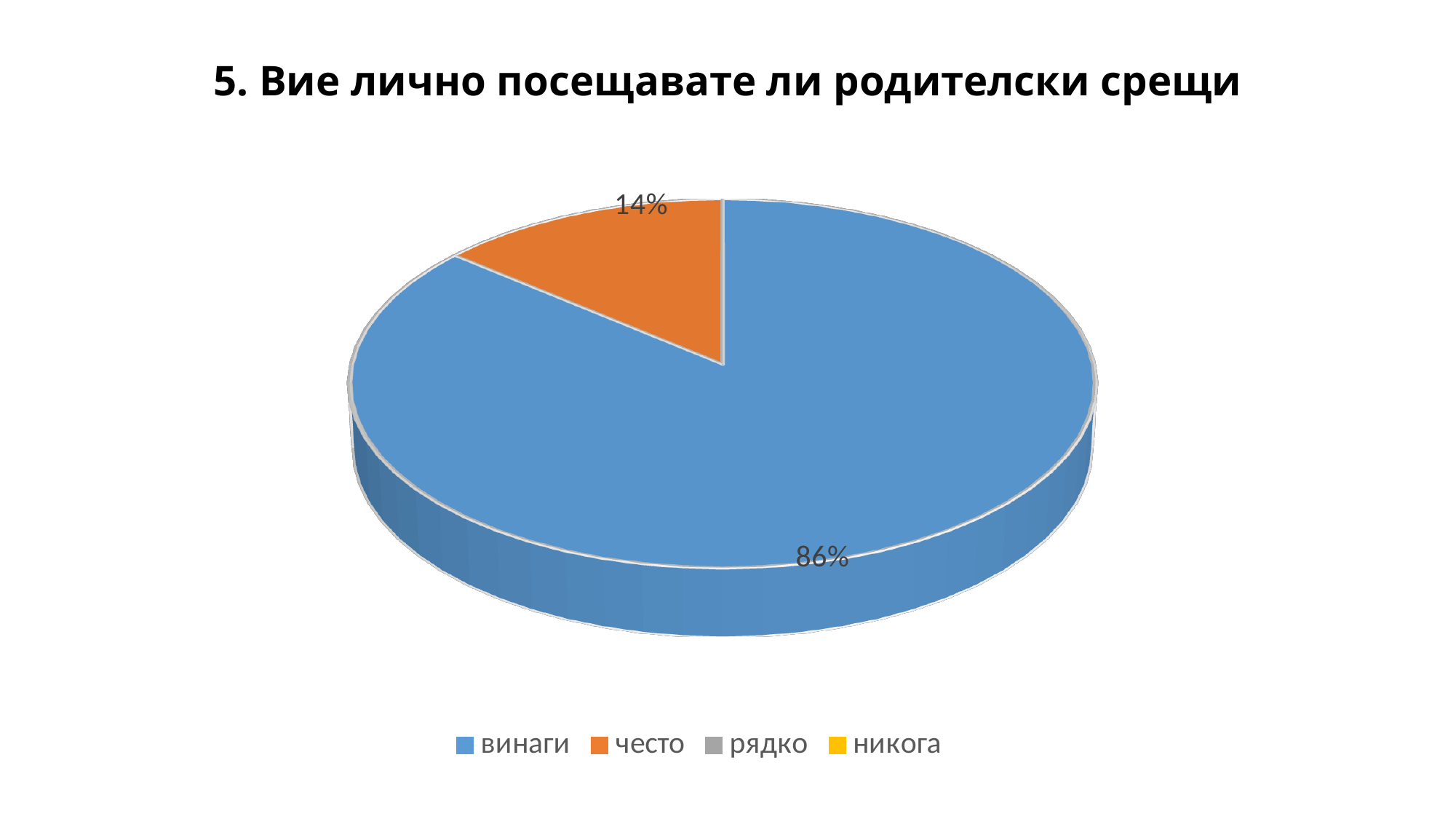
What is the difference in percentage points between the "винаги" slice and the "често" slice? 72 What share of the pie does "винаги" take? 86% How many entries does the legend list? 4 What kind of chart is shown on the slide? pie chart What is the title of the chart? 5. Вие лично посещавате ли родителски срещи What colour is the slice for "често"? orange Which category has the largest slice of the pie? винаги How many slices are visibly plotted in the pie? 2 What share of the pie does "често" take? 14% What is the total of the two labelled slices, 86% and 14%? 100% Which is larger, the slice for "винаги" or the slice for "често"? винаги